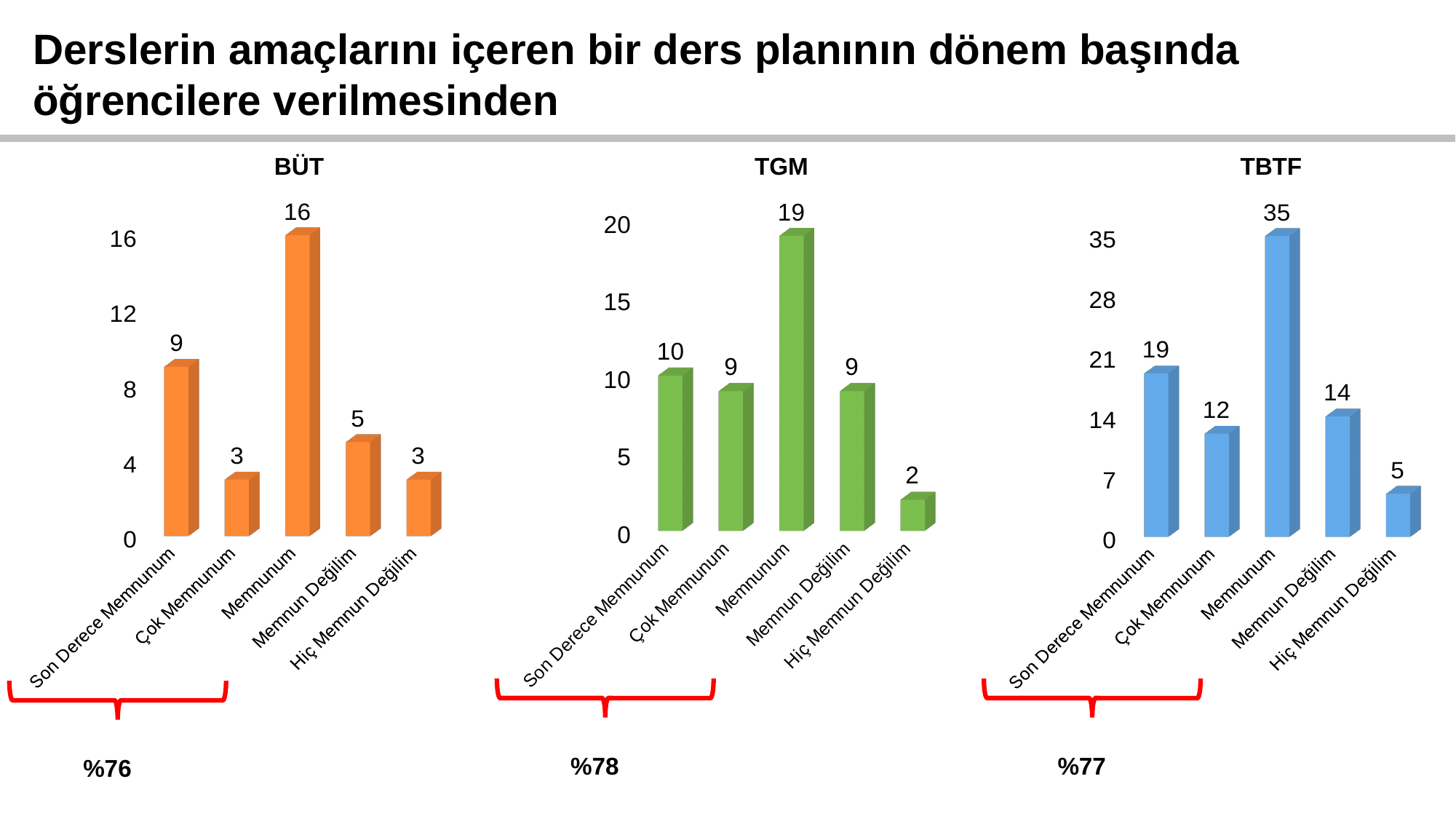
What colour are the bars in the TGM chart? green In the BÜT chart, what is the difference between Memnunum and Son Derece Memnunum? 7 What percentage is shown under the bracket beneath the TBTF chart? %77 In the BÜT chart, what is the value for Memnunum? 16 In the TGM chart, what is the value for Son Derece Memnunum? 10 In the TBTF chart, what is the difference between Son Derece Memnunum and Çok Memnunum? 7 In the TGM chart, which category has the lowest value? Hiç Memnun Değilim In the TBTF chart, which category has the highest value? Memnunum In the TBTF chart, what is the value for Memnun Değilim? 14 What kind of chart is the TGM chart? bar chart In the TGM chart, which is larger: Son Derece Memnunum or Hiç Memnun Değilim? Son Derece Memnunum How many categories does the BÜT chart show? 5